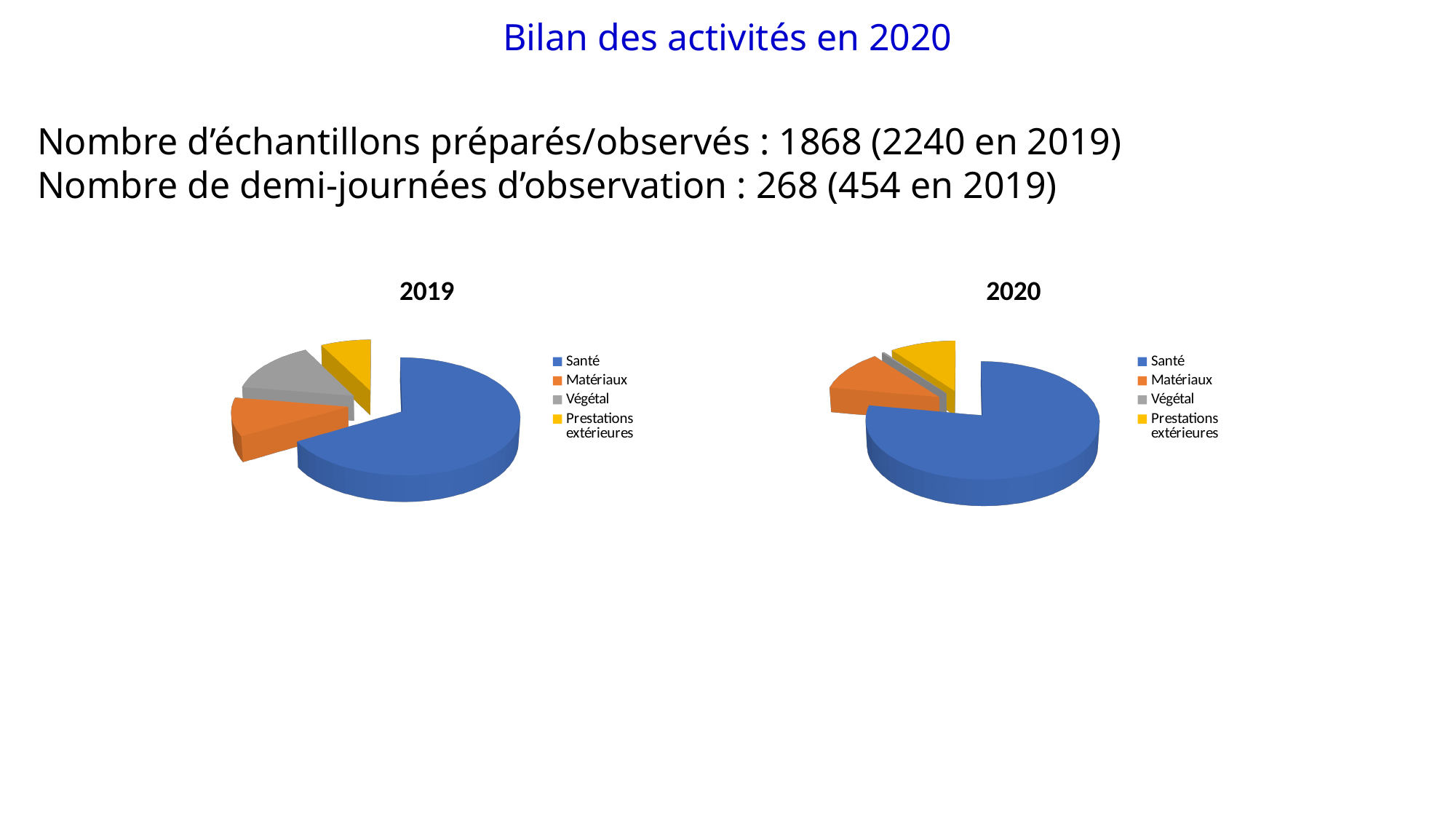
In the chart titled 2020, which colour represents Prestations extérieures? yellow What kind of chart is the chart titled 2020? pie chart In the chart titled 2019, which slice is larger, Santé or Matériaux? Santé In the chart titled 2020, which category has the largest slice? Santé In the chart titled 2020, which category has the smallest slice? Végétal In the chart titled 2019, which category has the largest slice? Santé In the chart titled 2019, which category has the smallest slice? Prestations extérieures In the chart titled 2020, how many categories does the legend list? 4 In the chart titled 2019, how many slices does the pie have? 4 In the chart titled 2020, which slice is larger, Matériaux or Végétal? Matériaux What kind of chart is the chart titled 2019? pie chart What are the titles of the two pie charts on the slide? 2019 and 2020